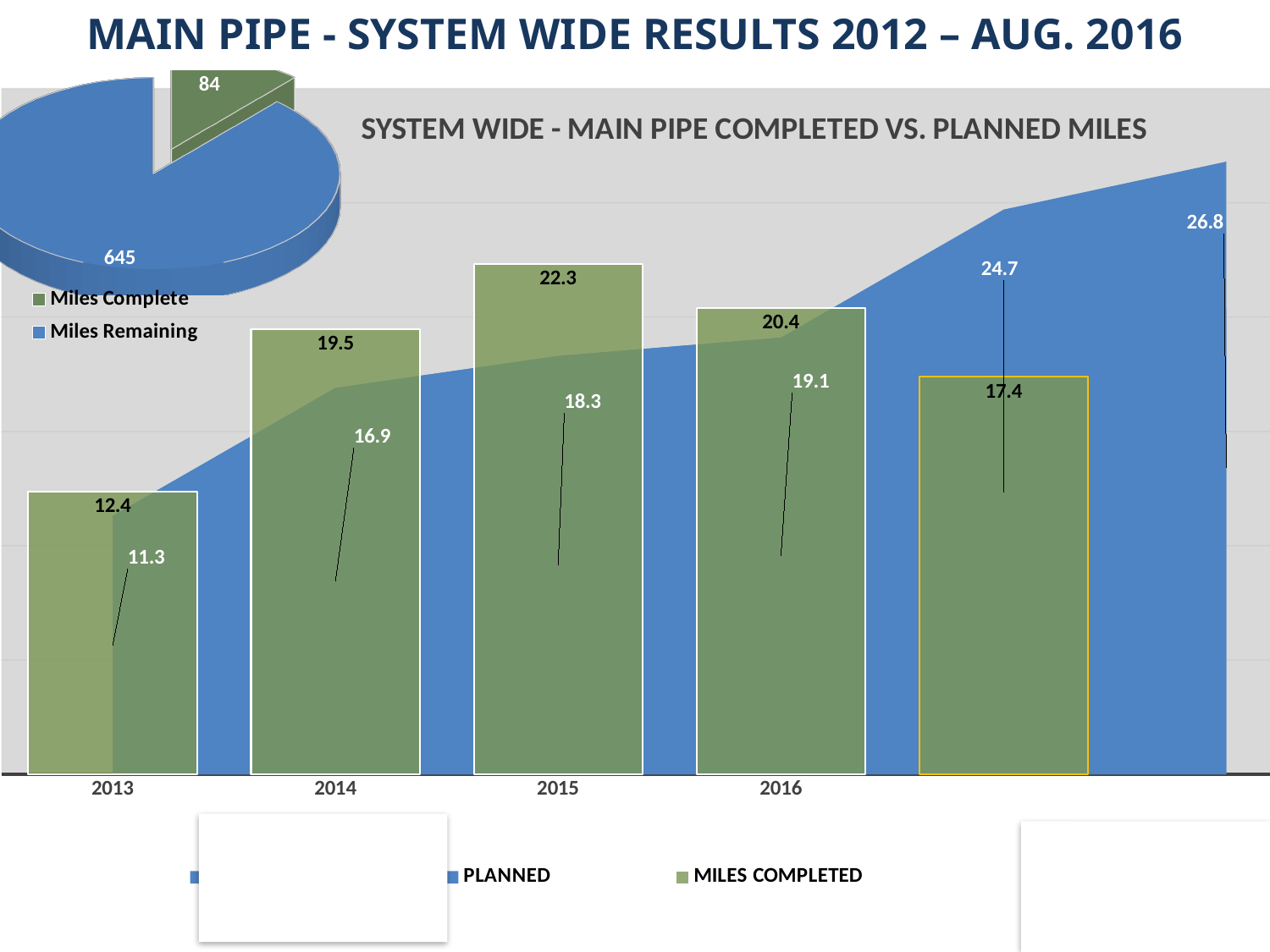
In the chart titled SYSTEM WIDE - MAIN PIPE COMPLETED VS. PLANNED MILES, what is the Planned value for 2014? 16.9 In the chart titled SYSTEM WIDE - MAIN PIPE COMPLETED VS. PLANNED MILES, what is the Miles Completed value for 2015? 22.3 In the chart titled SYSTEM WIDE - MAIN PIPE COMPLETED VS. PLANNED MILES, is the Miles Completed value for 2014 larger than the Planned value for 2014? Yes In the pie chart, what is the value for Miles Complete? 84 In the pie chart, which slice is larger, Miles Complete or Miles Remaining? Miles Remaining In the chart titled SYSTEM WIDE - MAIN PIPE COMPLETED VS. PLANNED MILES, which labeled year has the lowest Planned value? 2013 In the pie chart, what is the difference between Miles Remaining and Miles Complete? 561 In the pie chart, what is the value for Miles Remaining? 645 In the chart titled SYSTEM WIDE - MAIN PIPE COMPLETED VS. PLANNED MILES, which labeled year has the highest Miles Completed value? 2015 In the chart titled SYSTEM WIDE - MAIN PIPE COMPLETED VS. PLANNED MILES, what is the difference between Miles Completed and Planned for 2016? 1.3 In the chart titled SYSTEM WIDE - MAIN PIPE COMPLETED VS. PLANNED MILES, does the Planned series rise or fall from 2013 to 2016? Rise